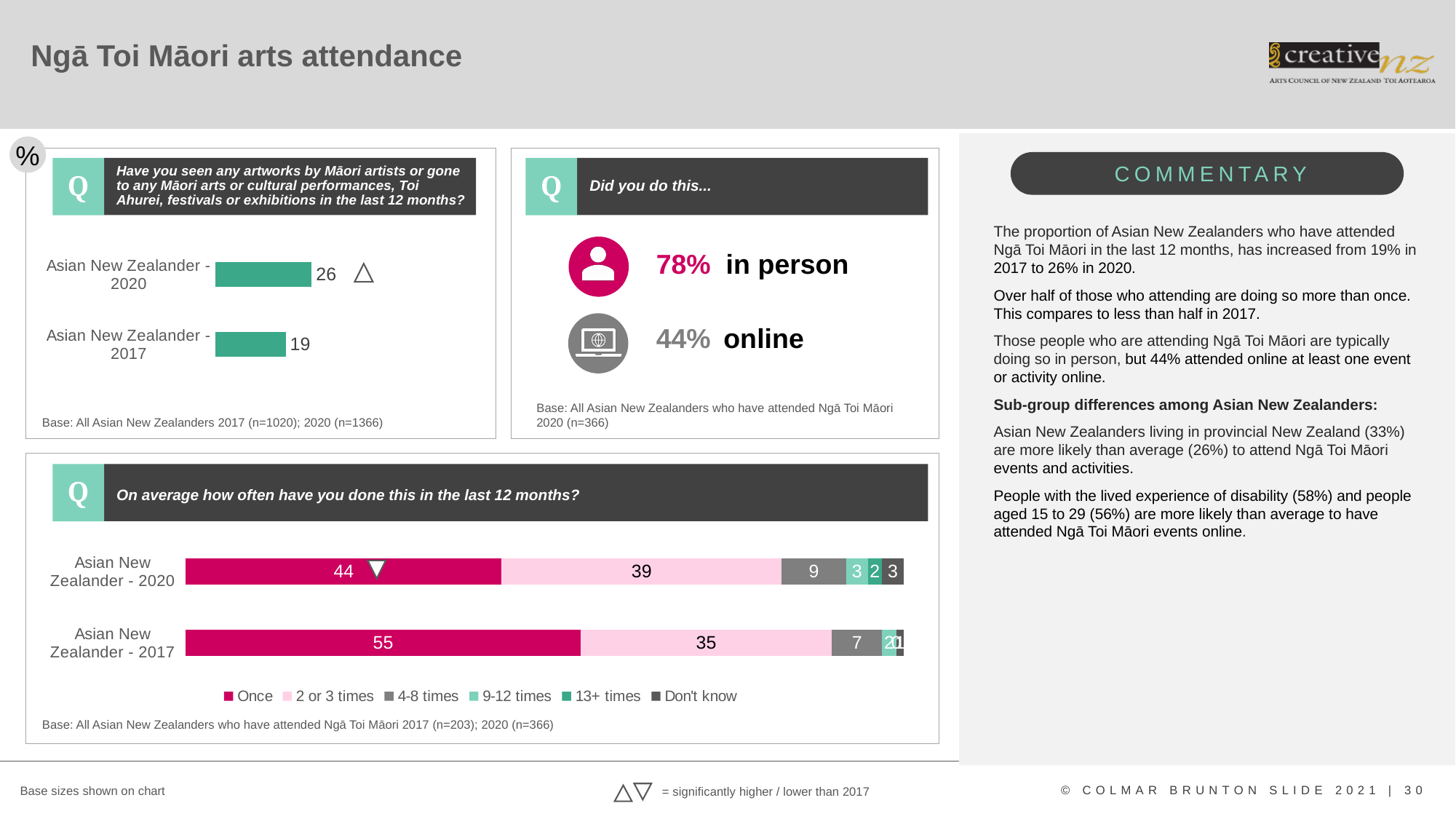
In the bottom chart on how often people attended, what is the total of the stacked bar for Asian New Zealander - 2020? 100 What kind of chart is the top-left chart on attendance of Ngā Toi Māori? bar chart In the top-left chart on attendance of Ngā Toi Māori, what is the value for Asian New Zealander - 2020? 26 In the top-left chart on attendance of Ngā Toi Māori, which year has the higher value, 2017 or 2020? 2020 In the bottom chart on how often people attended, which category has the largest value for Asian New Zealander - 2017? Once In the bottom chart on how often people attended, what is the value for '4-8 times' for Asian New Zealander - 2020? 9 In the bottom chart on how often people attended, what is the value for '2 or 3 times' for Asian New Zealander - 2017? 35 In the bottom chart on how often people attended, what is the difference in the 'Once' value between 2017 and 2020? 11 In the top-left chart on attendance of Ngā Toi Māori, what is the value for Asian New Zealander - 2017? 19 In the bottom chart on how often people attended, what is the value for 'Once' for Asian New Zealander - 2020? 44 In the bottom chart on how often people attended, how many series does the legend list? 6 In the top-left chart on attendance of Ngā Toi Māori, by how much did the value increase from 2017 to 2020? 7